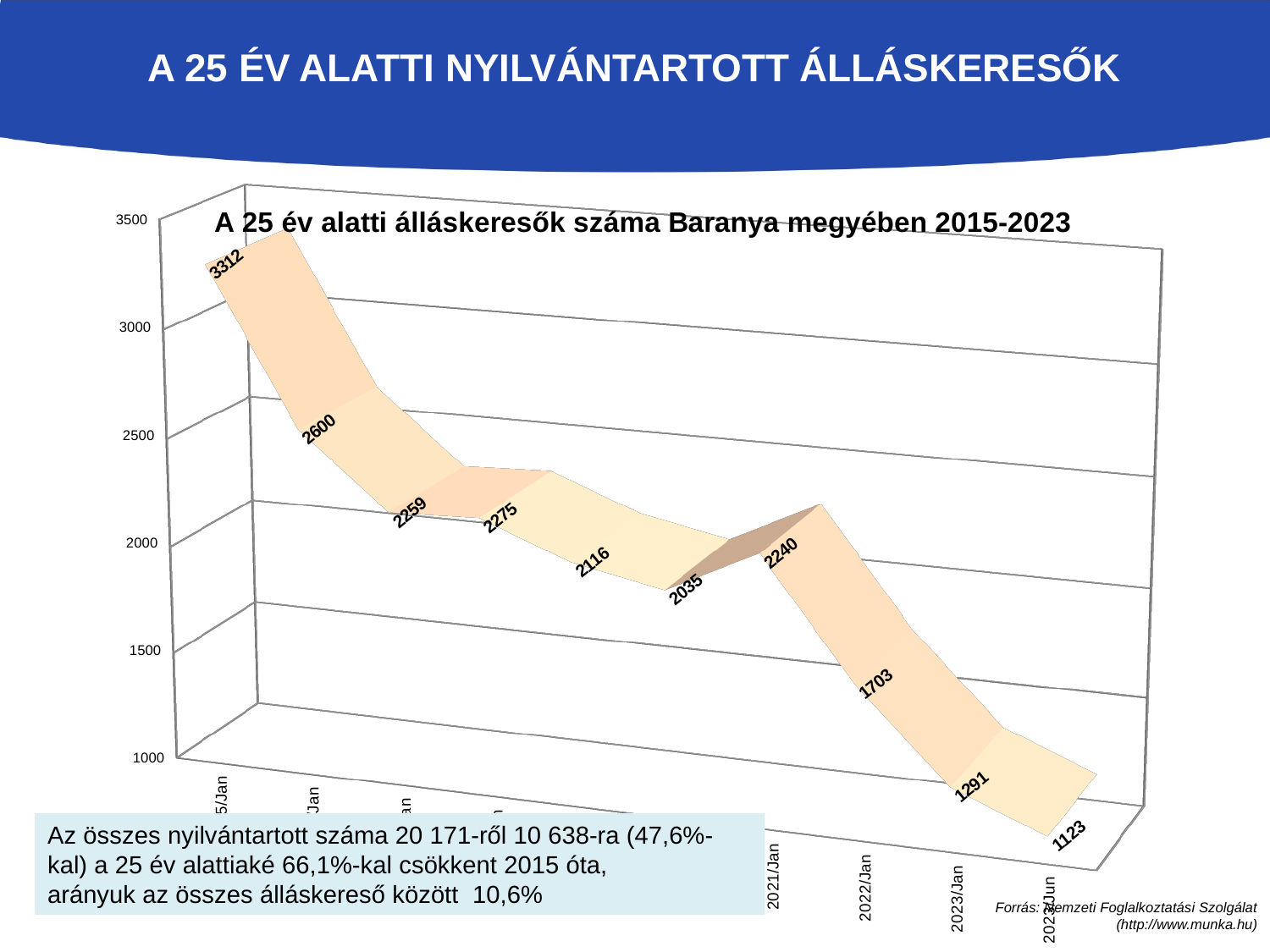
Do the values generally rise or fall from left to right along the x axis? fall What is the title of the chart? A 25 év alatti álláskeresők száma Baranya megyében 2015-2023 What is the value for 2021/Jan? 2240 What is the lowest value shown in the chart? 1123 What is the difference between the values for 2021/Jan and 2022/Jan? 537 What is the value for 2022/Jan? 1703 What is the highest value shown in the chart? 3312 What is the difference between the values for 2022/Jan and 2023/Jan? 412 What is the value for 2023/Jan? 1291 How many data points are plotted in the chart? 10 Which is larger, the value for 2021/Jan or the value for 2022/Jan? 2021/Jan What kind of chart is shown on the slide? 3D line chart